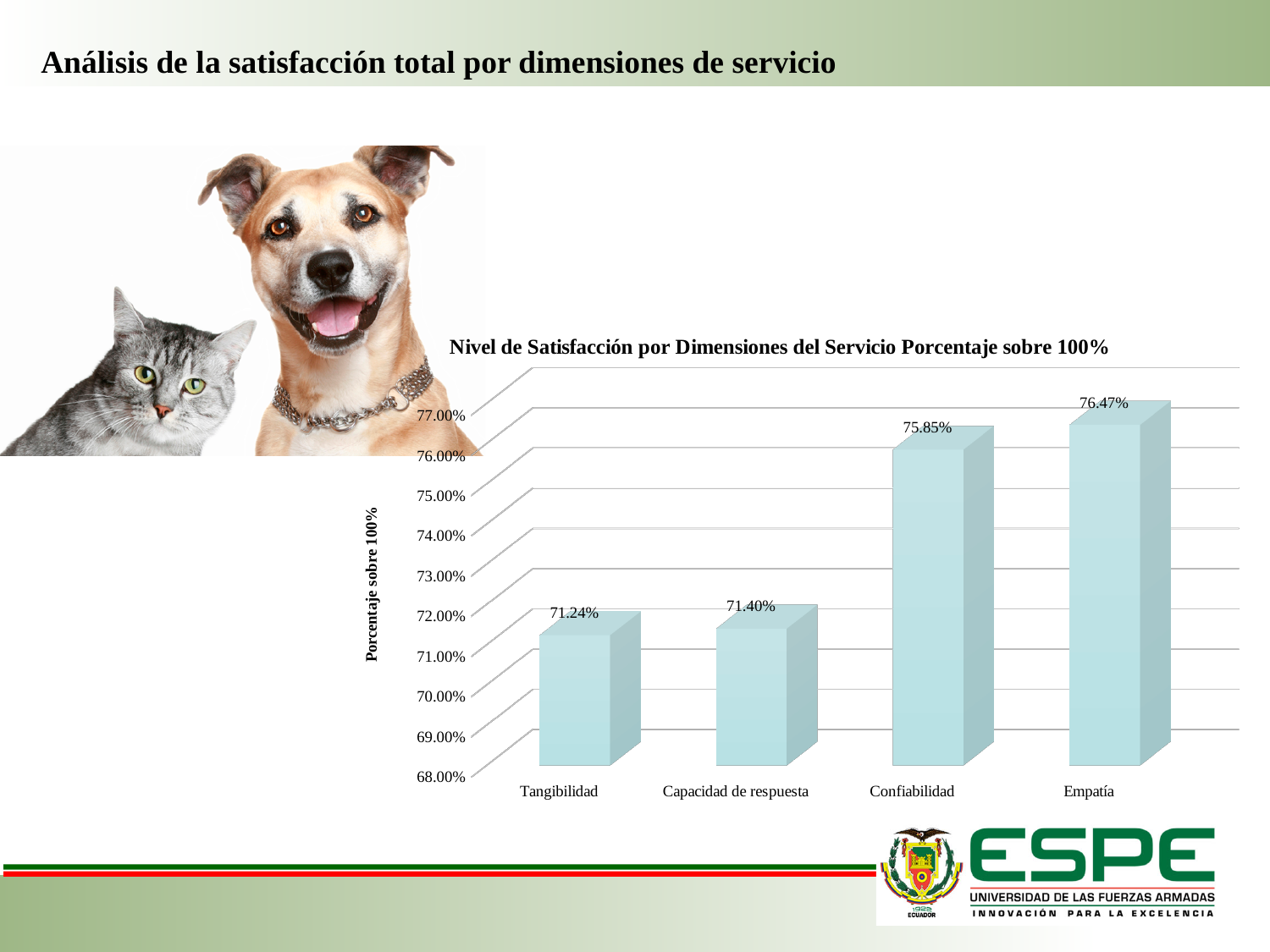
What is the title of the chart? Nivel de Satisfacción por Dimensiones del Servicio Porcentaje sobre 100% How many dimensions are shown on the chart? 4 What is the difference between the values for Confiabilidad and Capacidad de respuesta? 4.45% Which is larger, the value for Confiabilidad or the value for Capacidad de respuesta? Confiabilidad What is the satisfaction value for Confiabilidad? 75.85% What is the satisfaction value for Tangibilidad? 71.24% Which dimension has the highest satisfaction value? Empatía What is the difference between the values for Empatía and Tangibilidad? 5.23% What kind of chart is shown on the slide? Bar chart Which dimension has the lowest satisfaction value? Tangibilidad What is the satisfaction value for Empatía? 76.47% What is the satisfaction value for Capacidad de respuesta? 71.40%